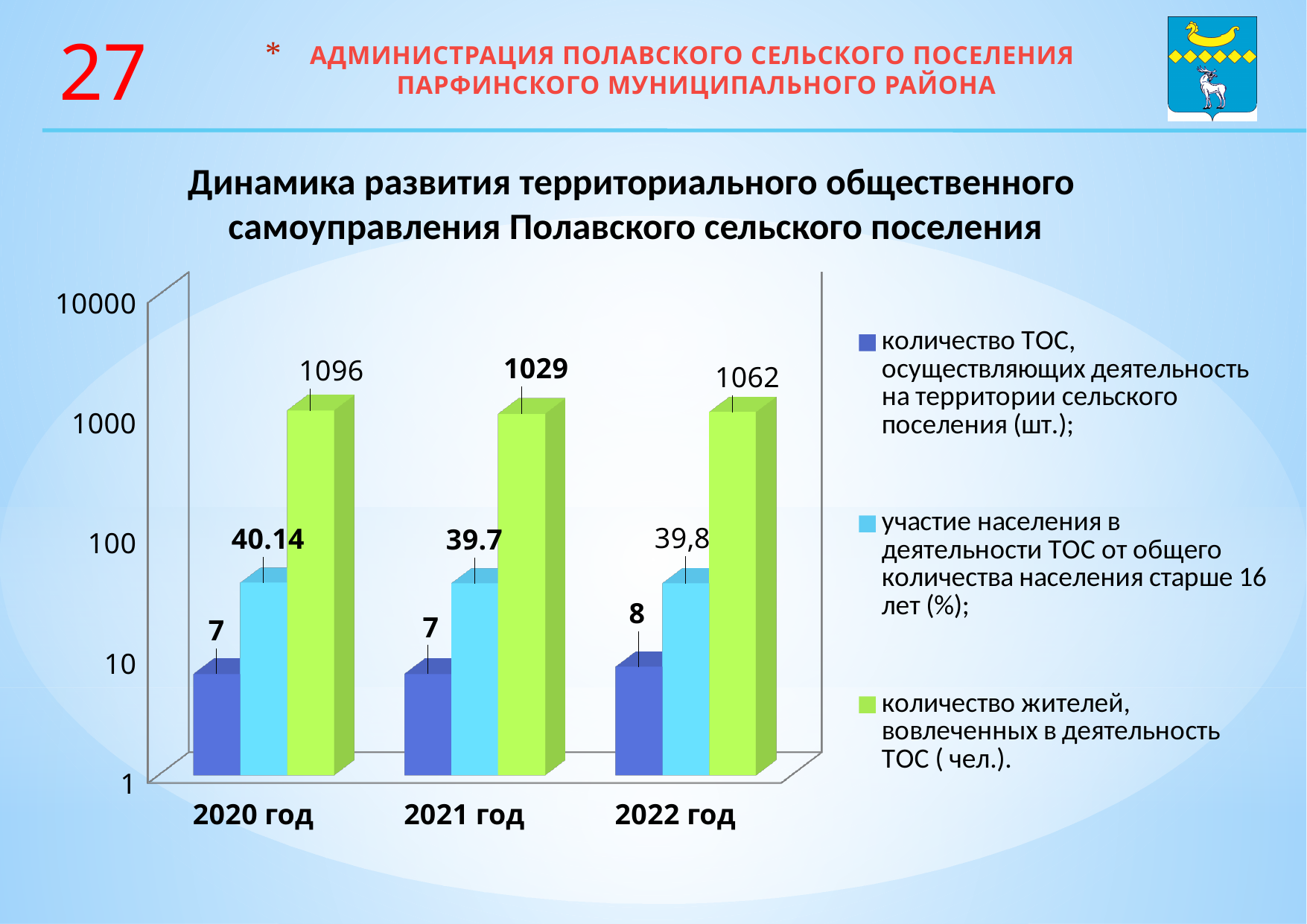
What is the population participation in TOS activity (участие населения в деятельности ТОС) for 2021 год? 39.7 How many series does the chart legend list? 3 How many TOS (количество ТОС) are shown for 2022 год? 8 What is the number of residents involved in TOS activity (количество жителей, вовлеченных в деятельность ТОС) in 2020 год? 1096 What is the difference between the number of residents involved in TOS activity in 2020 год and 2021 год? 67 What type of chart is shown on the slide? Bar chart What is the data label for population participation in TOS activity in 2022 год? 39,8 In which year is the number of residents involved in TOS activity the lowest? 2021 год Which year has more residents involved in TOS activity, 2020 год or 2022 год? 2020 год How many years (categories) are shown on the x axis of the chart? 3 In which year is the number of residents involved in TOS activity the highest? 2020 год By how much did the number of TOS (количество ТОС) change from 2020 год to 2022 год? 1